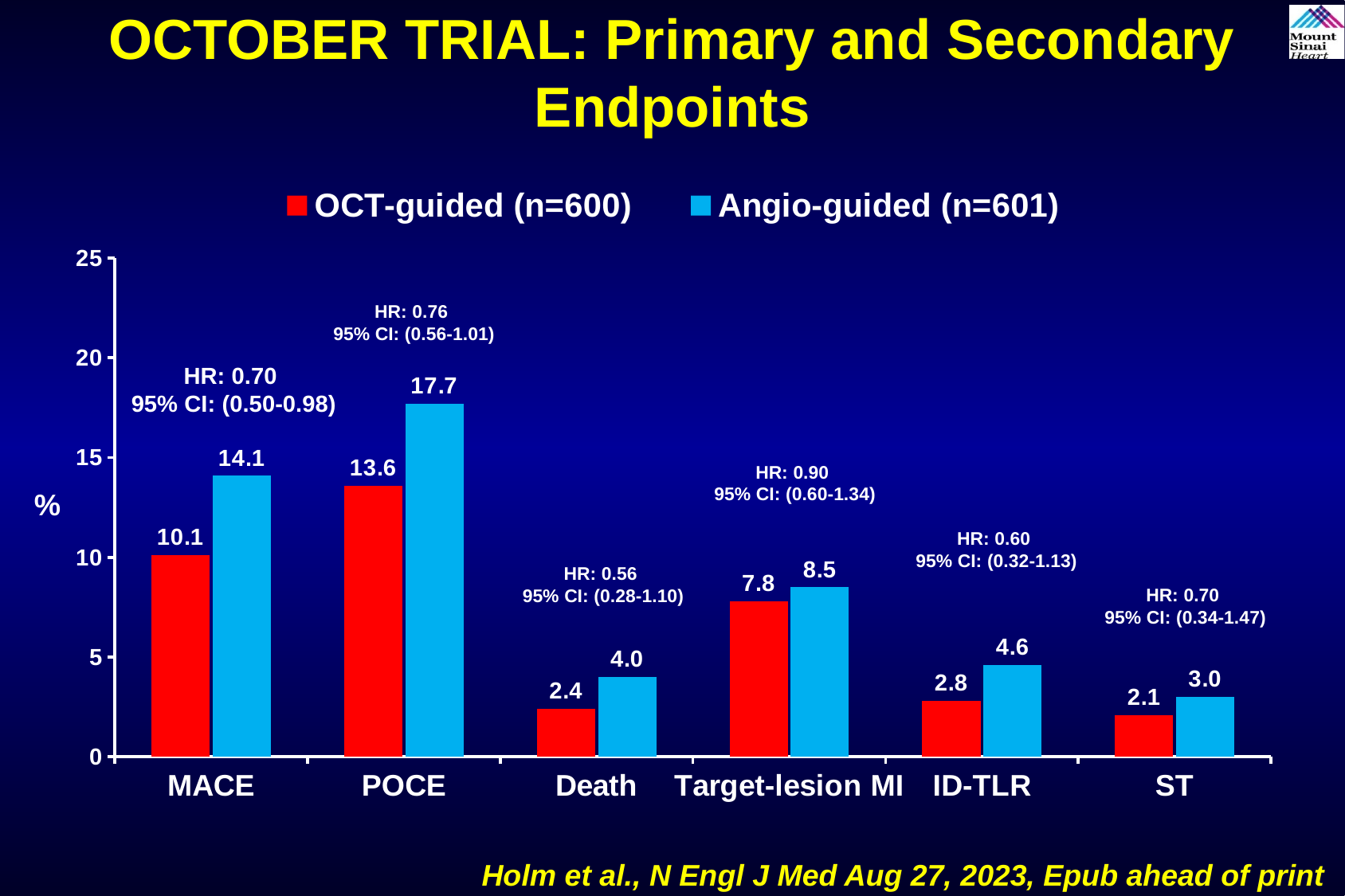
What is the value for Angio-guided (n=601) in the POCE category? 17.7 What is the hazard ratio (HR) shown above the MACE bars? 0.70 Which is larger for ID-TLR: the OCT-guided (n=600) value or the Angio-guided (n=601) value? Angio-guided (n=601) How many series does the legend list? 2 What is the value for OCT-guided (n=600) in the MACE category? 10.1 Which category has the highest value for Angio-guided (n=601)? POCE What is the difference between the Angio-guided (n=601) and OCT-guided (n=600) values for MACE? 4.0 What colour represents the OCT-guided (n=600) series? Red What is the value for Angio-guided (n=601) in the Death category? 4.0 What kind of chart is shown on the slide? Bar chart Which category has the lowest value for OCT-guided (n=600)? ST How many categories are shown on the x axis? 6